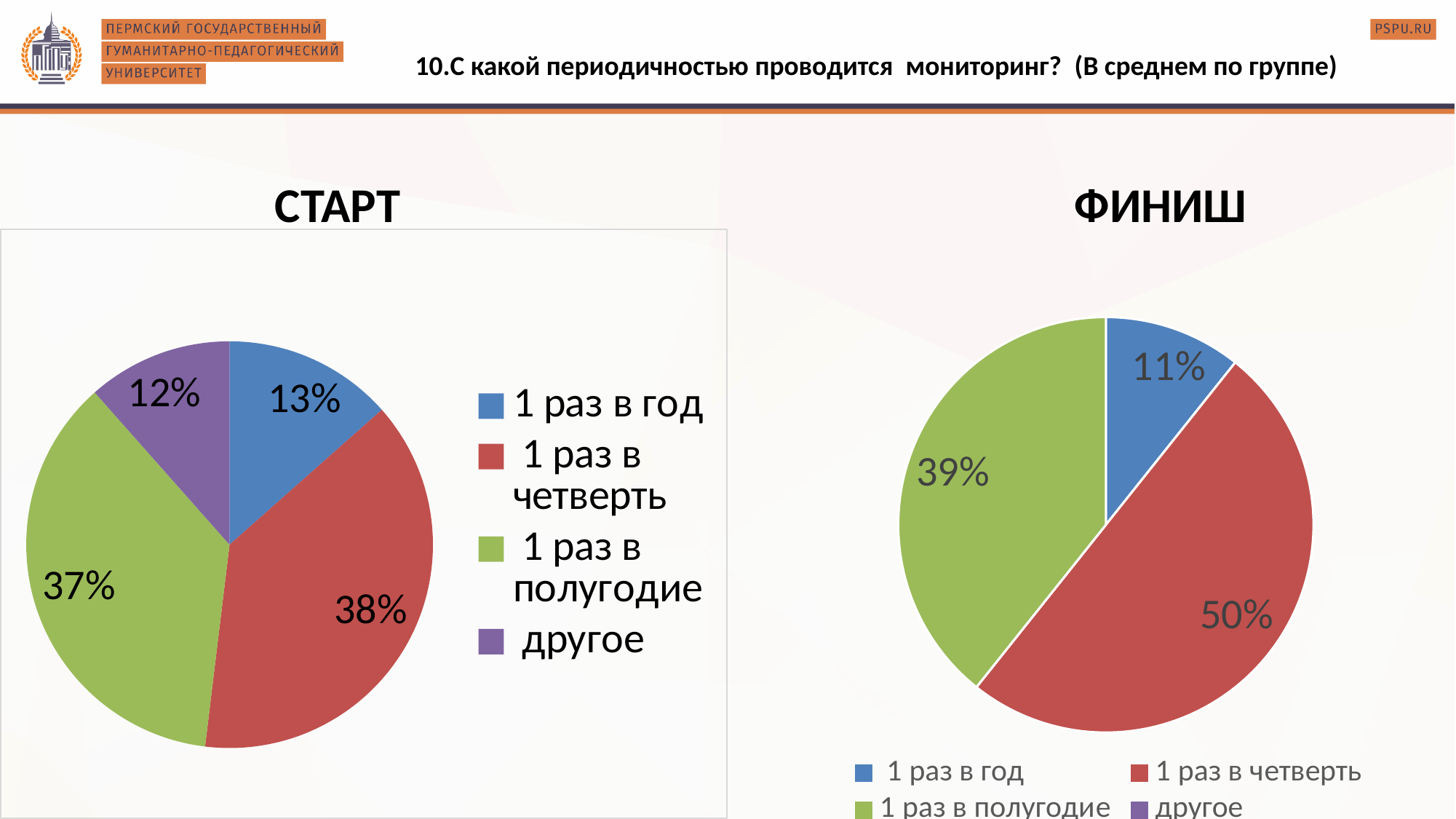
In the СТАРТ pie chart, which category has the smallest share? другое In the ФИНИШ pie chart, what percentage is shown for '1 раз в полугодие'? 39% In the ФИНИШ pie chart, what percentage is shown for '1 раз в четверть'? 50% In the СТАРТ chart legend, which colour represents 'другое'? Purple How many entries does the legend of the СТАРТ chart list? 4 In the СТАРТ pie chart, which is larger: '1 раз в полугодие' or '1 раз в год'? 1 раз в полугодие In the СТАРТ pie chart, what percentage is shown for '1 раз в четверть'? 38% In the СТАРТ pie chart, what percentage is shown for 'другое'? 12% In the ФИНИШ pie chart, which category has the largest share? 1 раз в четверть What type of chart is used for the ФИНИШ data? Pie chart What is the difference between the '1 раз в четверть' share in the ФИНИШ chart and in the СТАРТ chart? 12% In the СТАРТ pie chart, what percentage is shown for '1 раз в год'? 13%